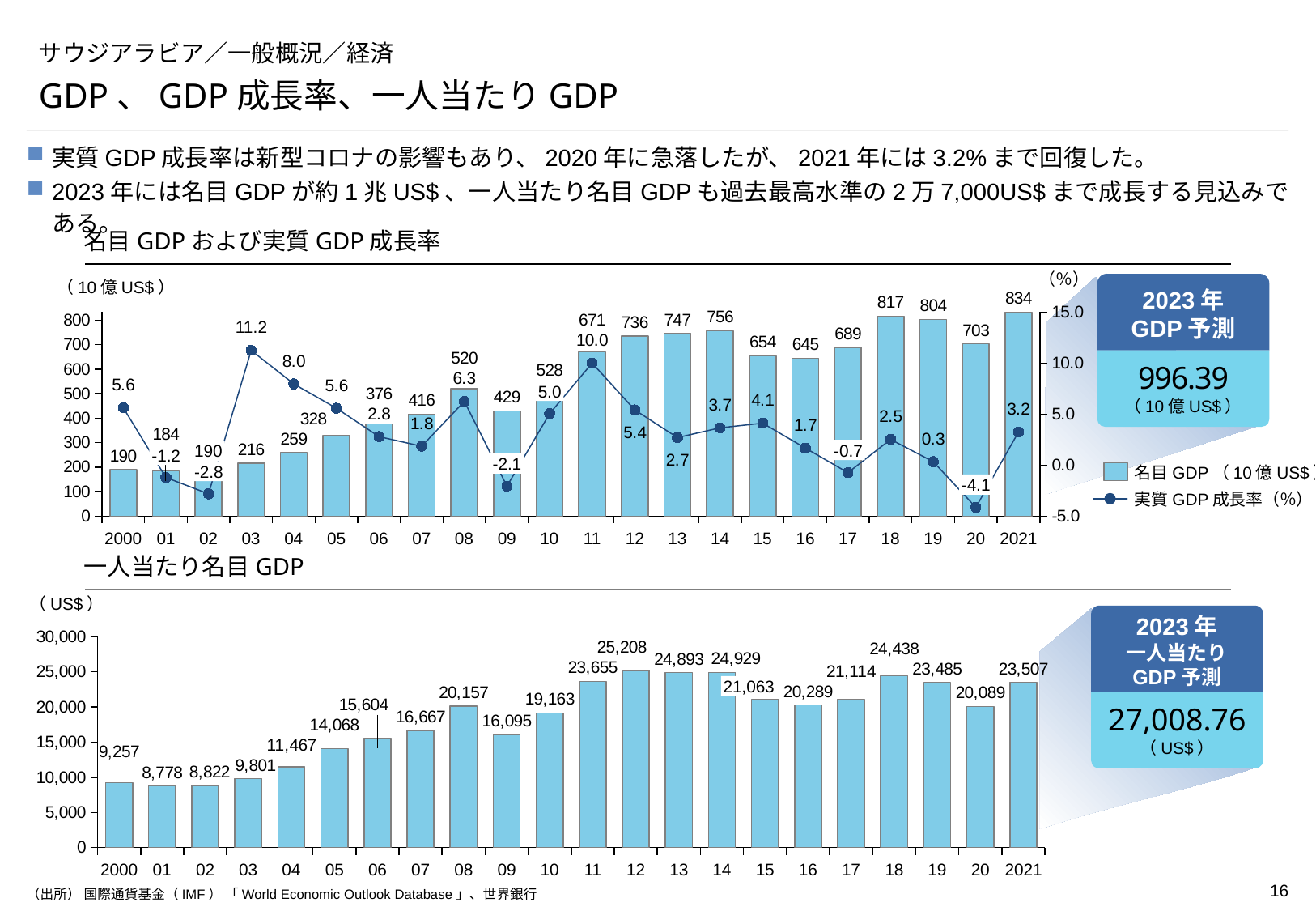
In the chart titled 一人当たり名目GDP, how many years are plotted on the x axis? 22 In the chart titled 名目GDPおよび実質GDP成長率, how many series does the legend list? 2 In the chart titled 一人当たり名目GDP, which year has the lowest value? 01 In the chart titled 一人当たり名目GDP, what is the value for 2012? 25,208 In the chart titled 一人当たり名目GDP, which is larger, the value for 2008 or the value for 2009? 2008 In the chart titled 名目GDPおよび実質GDP成長率, which year has the highest nominal GDP? 2021 What kind of chart is the chart titled 一人当たり名目GDP? bar chart In the chart titled 名目GDPおよび実質GDP成長率, what is the real GDP growth rate for 2003? 11.2 In the chart titled 名目GDPおよび実質GDP成長率, what is the nominal GDP value for 2021? 834 In the chart titled 名目GDPおよび実質GDP成長率, what is the difference in nominal GDP between 2018 and 2019? 13 In the chart titled 一人当たり名目GDP, what is the difference between the values for 2021 and 20? 3,418 In the chart titled 名目GDPおよび実質GDP成長率, which year has the lowest real GDP growth rate? 20